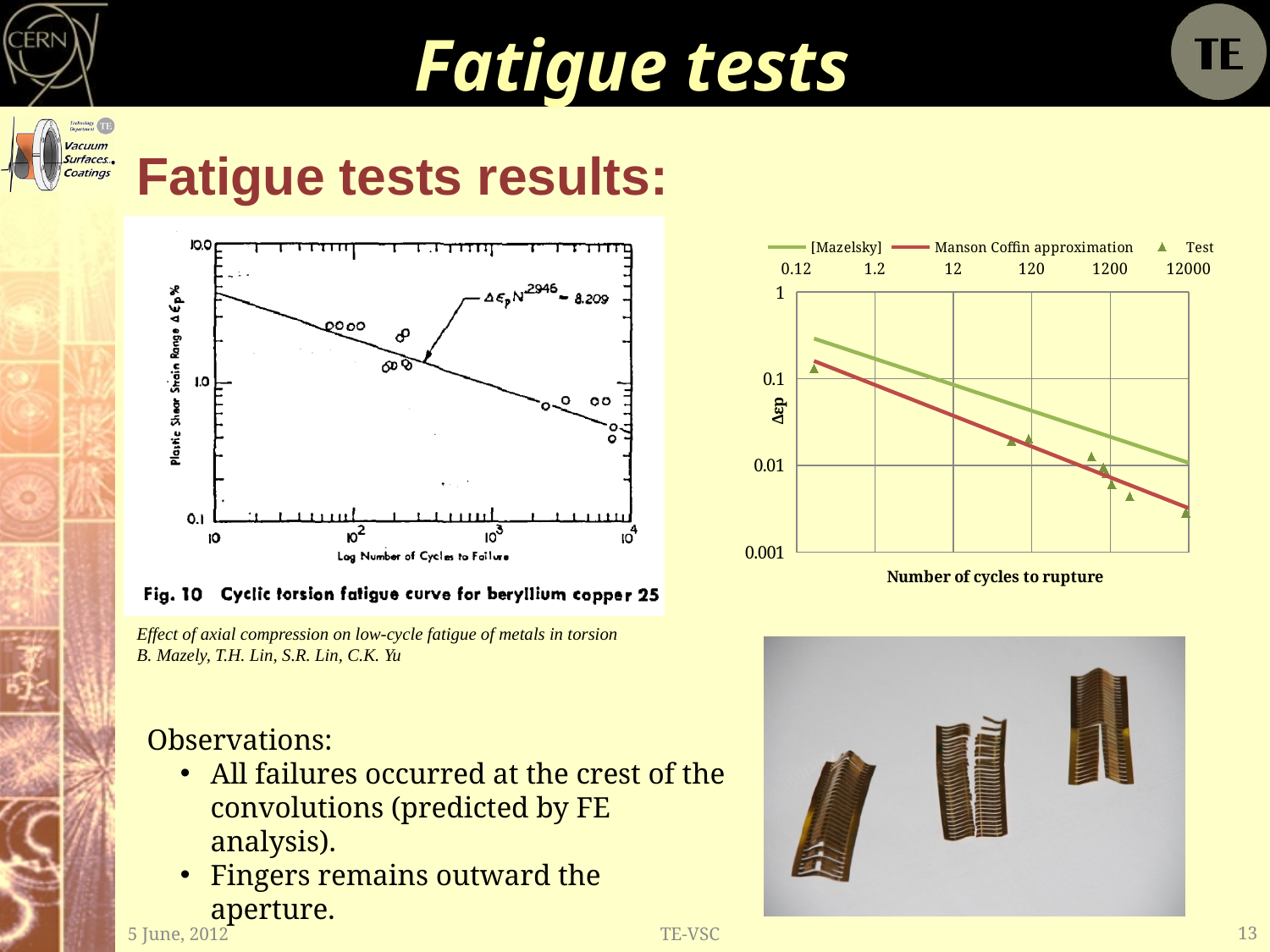
What is the caption title of the figure on the left (Fig. 10)? Cyclic torsion fatigue curve for beryllium copper 25 In the chart on the right, what is the title of the x axis? Number of cycles to rupture In the chart on the right, which line lies higher, [Mazelsky] or Manson Coffin approximation? [Mazelsky] In the chart on the right, is the Manson Coffin approximation value at 0.12 cycles greater or less than 0.1? greater In the chart on the right, how many series does the legend list? 3 In the chart on the right, is the Test value near 12000 cycles greater or less than 0.01? less In the chart on the right, do the [Mazelsky] and Manson Coffin approximation lines rise or fall as the number of cycles to rupture increases? fall In the chart on the right, what is the lowest value shown on the y axis? 0.001 In the chart on the right, are the Test values near 120 cycles greater or less than 0.1? less